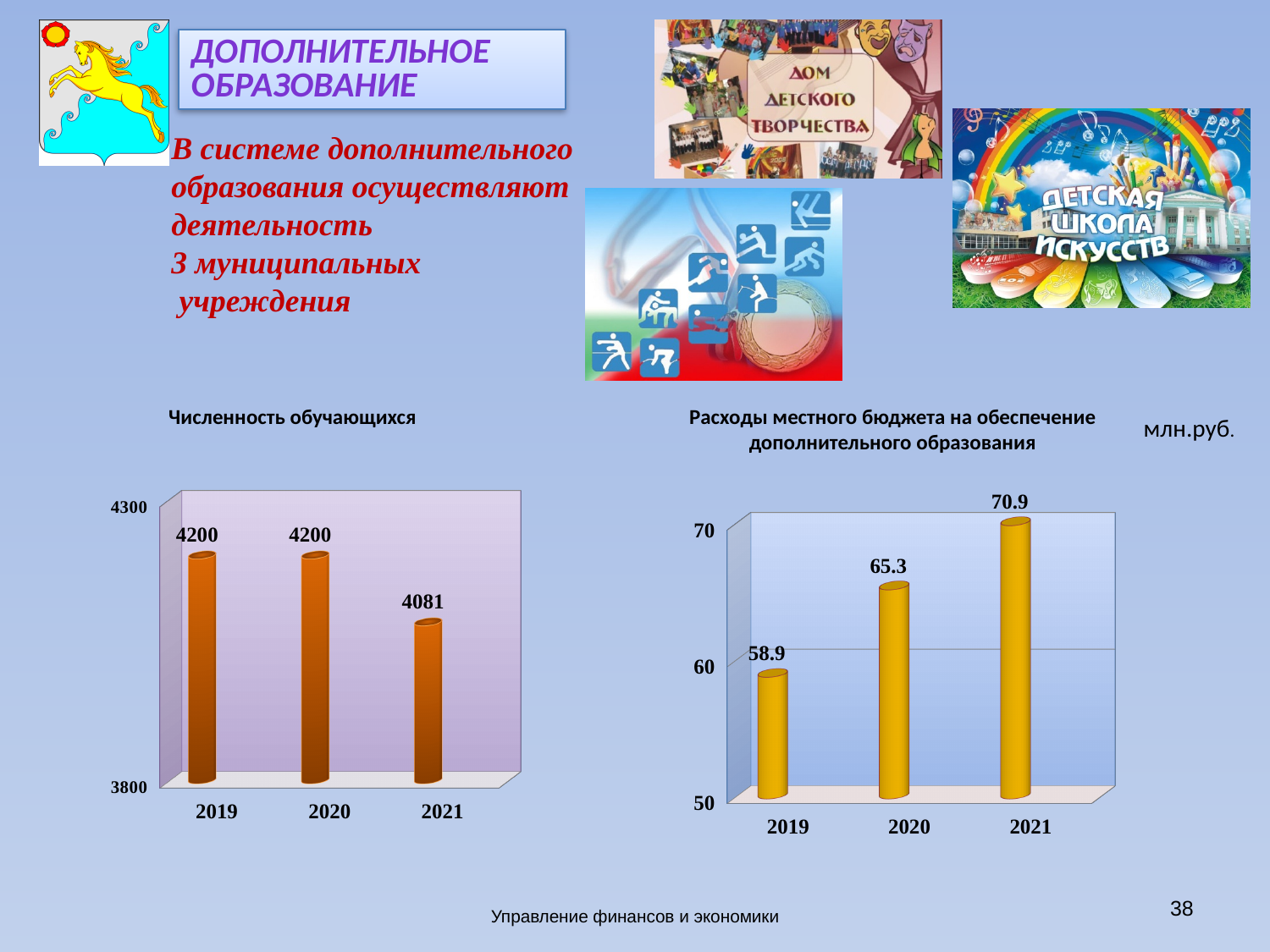
What kind of chart is the 'Расходы местного бюджета на обеспечение дополнительного образования' chart? bar chart In the 'Численность обучающихся' chart, what is the difference between the 2020 and 2021 values? 119 In the 'Расходы местного бюджета на обеспечение дополнительного образования' chart, do the values rise or fall from 2019 to 2021? rise In the 'Численность обучающихся' chart, how many years are shown? 3 In the 'Численность обучающихся' chart, what is the value for 2019? 4200 In the 'Численность обучающихся' chart, what is the value for 2021? 4081 In the 'Численность обучающихся' chart, which year has the lowest value? 2021 In the 'Расходы местного бюджета на обеспечение дополнительного образования' chart, what is the value for 2021? 70.9 In the 'Расходы местного бюджета на обеспечение дополнительного образования' chart, what is the difference between the 2021 and 2019 values? 12.0 In the 'Расходы местного бюджета на обеспечение дополнительного образования' chart, which year has the highest value? 2021 In the 'Расходы местного бюджета на обеспечение дополнительного образования' chart, what is the value for 2020? 65.3 In the 'Расходы местного бюджета на обеспечение дополнительного образования' chart, is the value for 2019 greater or less than 60? less